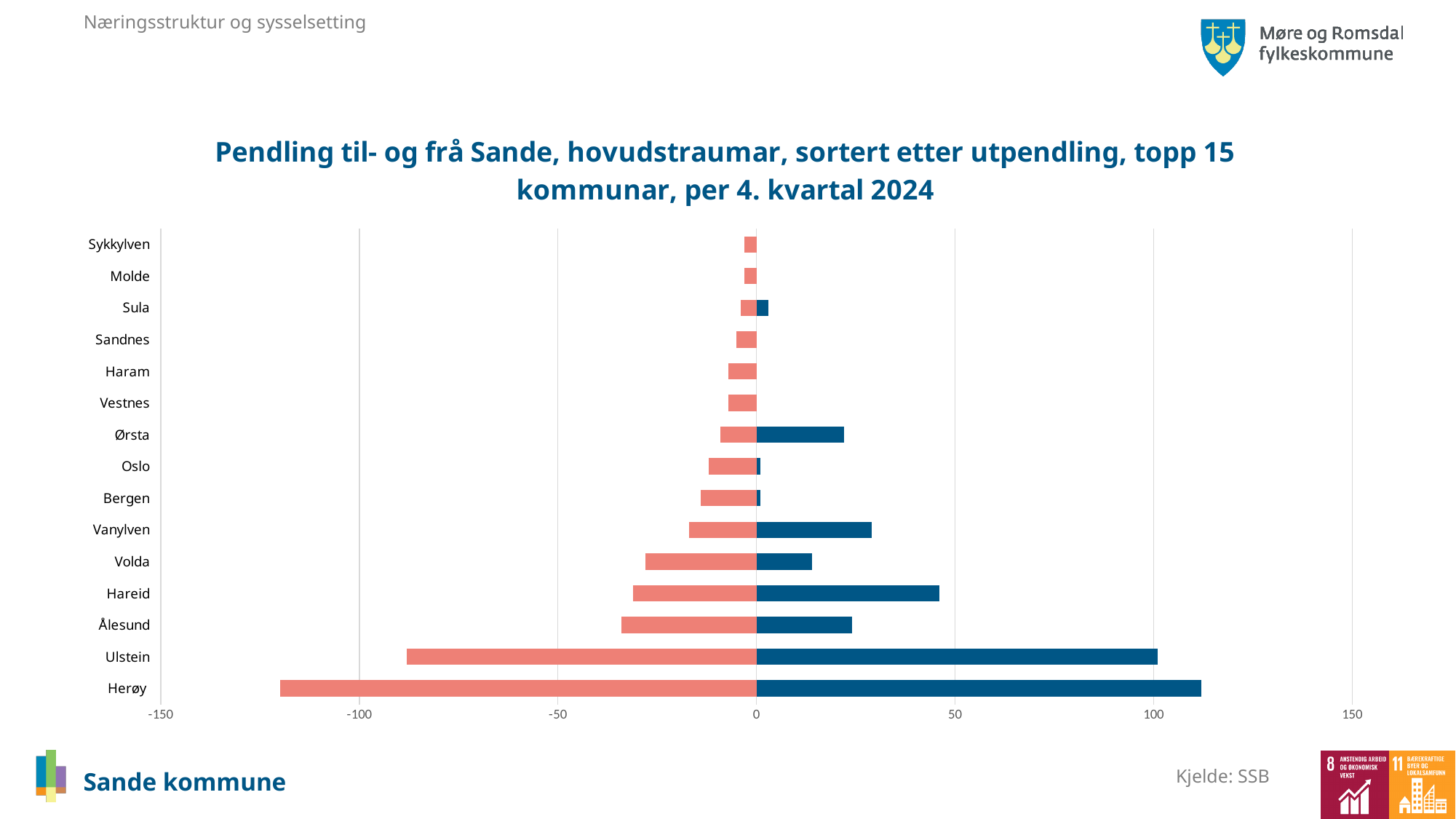
Is the blue bar value for Hareid greater or less than 50? less Which municipality has the longest red bar (most negative value) in the chart? Herøy Which has the larger blue bar, Hareid or Ålesund? Hareid Is the red bar value for Ulstein greater or less than -100? greater Which municipality has the longest blue bar (largest positive value) in the chart? Herøy Is the red bar value for Herøy greater or less than -100? less What kind of chart is shown on the slide? Bar chart Which has the larger blue bar, Ulstein or Hareid? Ulstein Which municipality is listed at the top of the chart's vertical axis? Sykkylven How many municipalities (categories) are listed on the vertical axis of the chart? 15